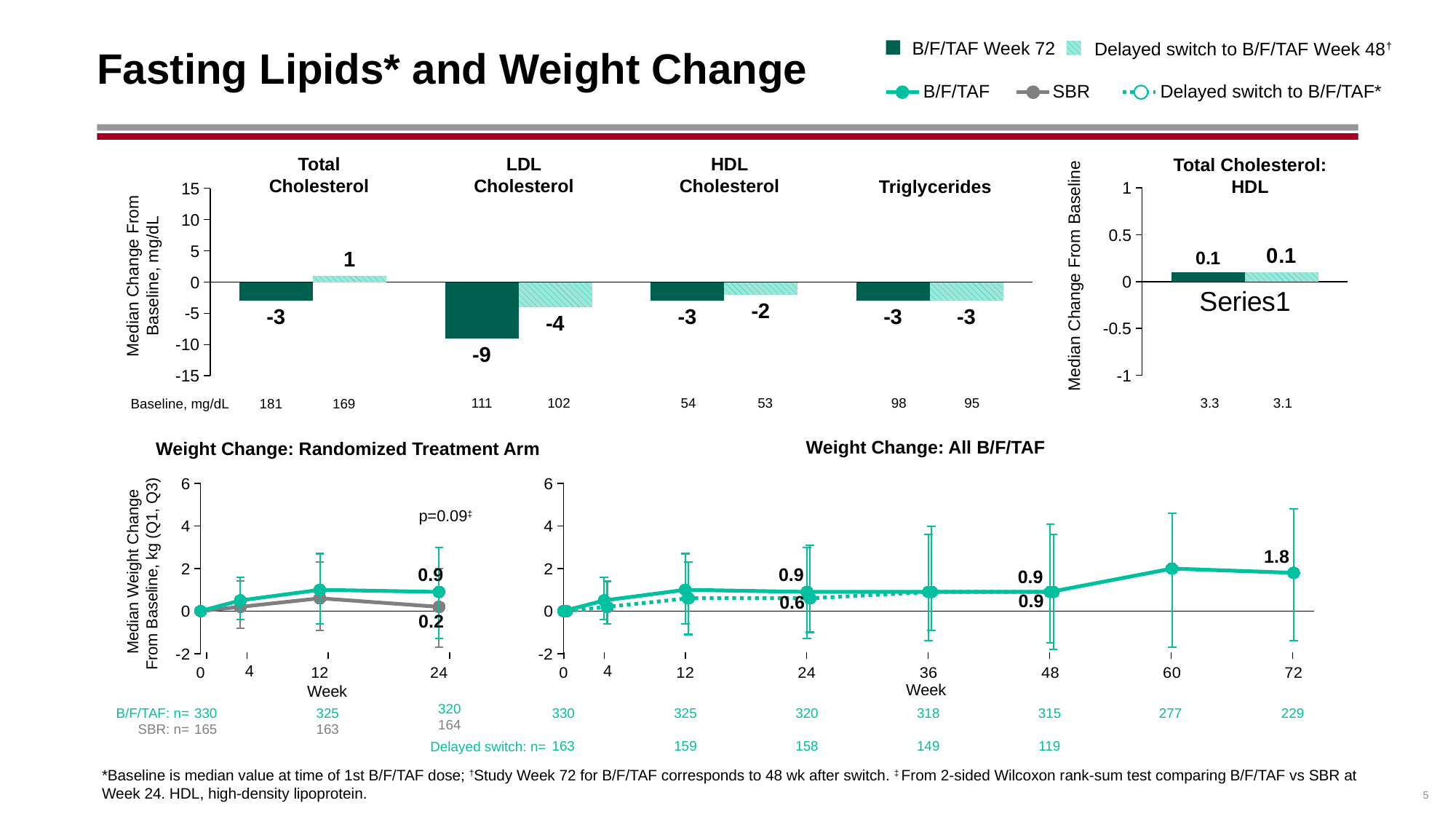
In the fasting lipids bar chart, which lipid category has the lowest B/F/TAF Week 72 value? LDL Cholesterol In the fasting lipids bar chart, what is the B/F/TAF Week 72 median change for LDL Cholesterol? -9 What kind of chart is the Weight Change: All B/F/TAF chart? Line chart In the Weight Change: Randomized Treatment Arm chart, what is the B/F/TAF median weight change at Week 24? 0.9 In the Weight Change: Randomized Treatment Arm chart, which arm has the larger median weight change at Week 24, B/F/TAF or SBR? B/F/TAF In the Total Cholesterol: HDL chart, what is the B/F/TAF Week 72 median change from baseline? 0.1 How many lipid categories are shown in the fasting lipids bar chart? 4 In the Weight Change: All B/F/TAF chart, what is the median weight change at Week 72? 1.8 In the Weight Change: Randomized Treatment Arm chart, what is the difference between the B/F/TAF and SBR values at Week 24? 0.7 In the fasting lipids bar chart, what is the difference between the B/F/TAF Week 72 and Delayed switch values for LDL Cholesterol? 5 In the fasting lipids bar chart, what is the Delayed switch to B/F/TAF Week 48 median change for Total Cholesterol? 1 What kind of chart is the fasting lipids chart at the top left? Bar chart